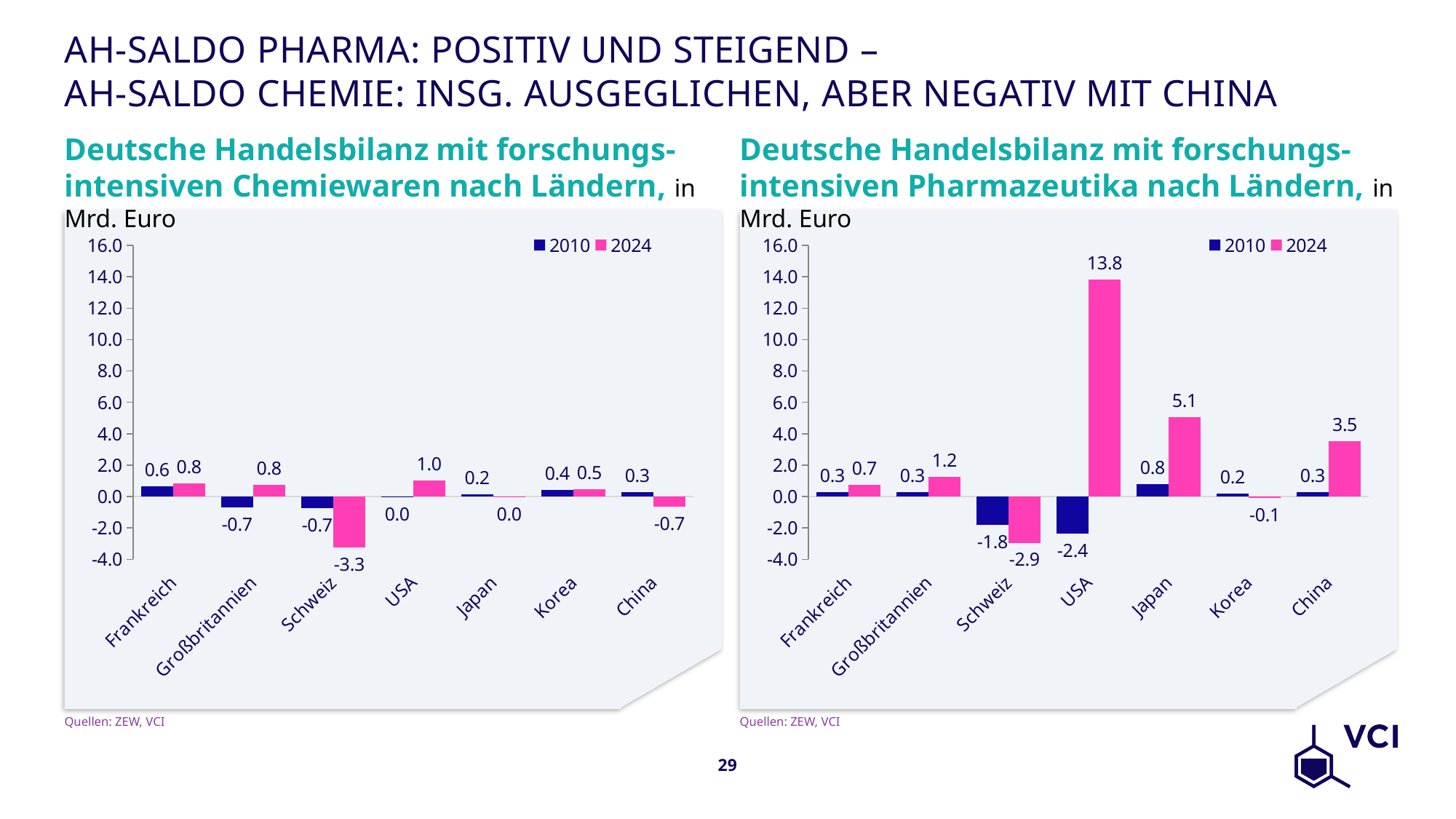
How many series does the legend of the right chart (Pharmazeutika) list? 2 In the left chart (Chemiewaren), what is the difference between the 2024 values for USA and Japan? 1.0 In the right chart (Pharmazeutika), what is the difference between the 2024 and 2010 values for USA? 16.2 How many countries are shown on the x axis of the left chart (Chemiewaren)? 7 In the right chart (Pharmazeutika), what is the value for USA in 2024? 13.8 In the right chart (Pharmazeutika), which is larger: the 2024 value for Japan or the 2024 value for China? Japan In the right chart (Pharmazeutika), what is the value for Japan in 2010? 0.8 In the left chart (Chemiewaren), what is the value for Schweiz in 2024? -3.3 What type of chart is the left chart (Chemiewaren)? Bar chart In the left chart (Chemiewaren), what is the value for China in 2024? -0.7 In the right chart (Pharmazeutika), which country has the highest 2024 value? USA In the left chart (Chemiewaren), which country has the lowest 2024 value? Schweiz